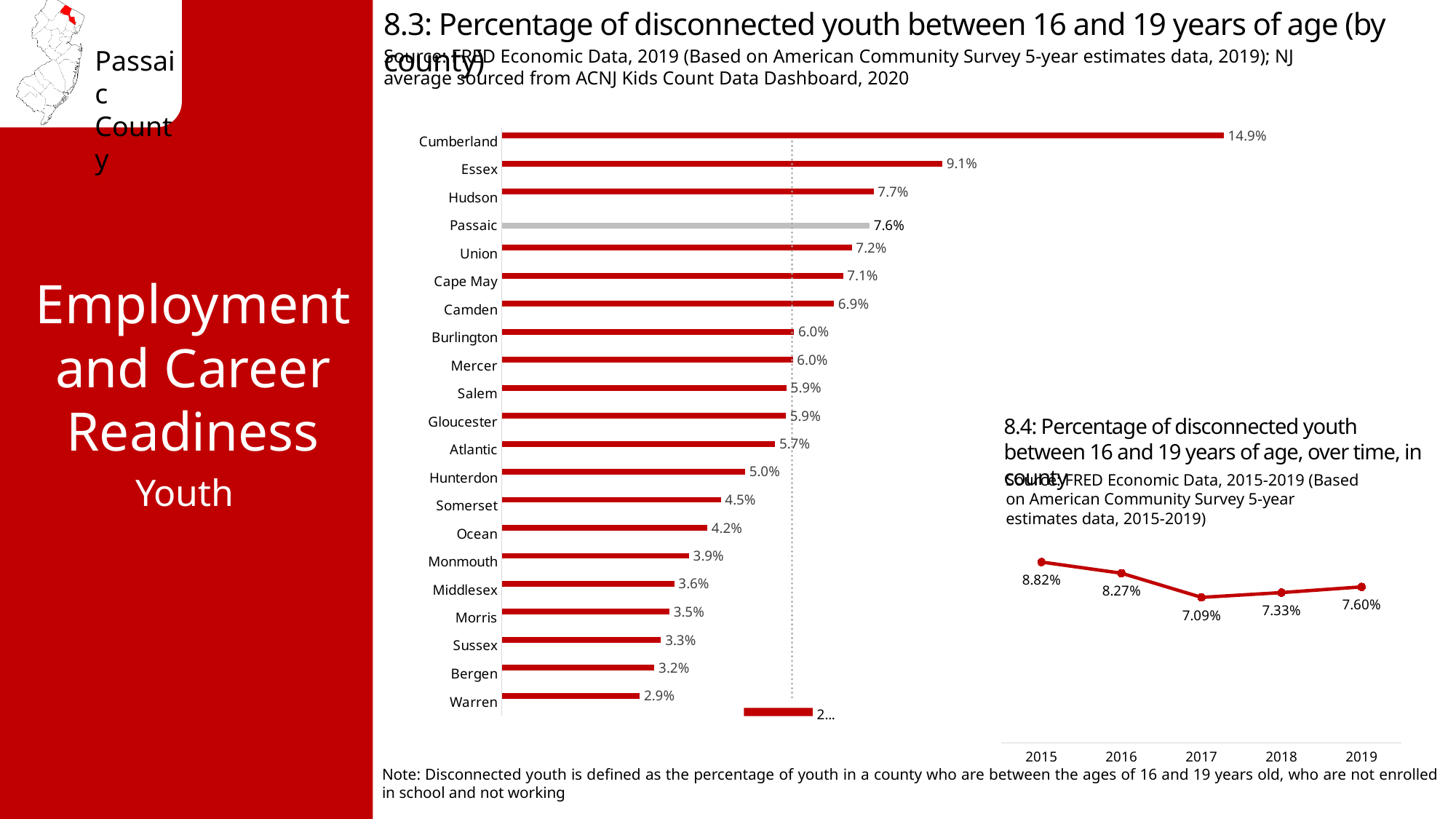
In the chart 8.3 (percentage of disconnected youth by county), what is the value for Passaic? 7.6% In the chart 8.3 (by county), which has a higher value, Hudson or Union? Hudson In the chart 8.4 (disconnected youth over time), what is the value for 2017? 7.09% In the chart 8.3 (by county), what is the value for Bergen? 3.2% In the chart 8.4 (disconnected youth over time), how many years are plotted? 5 What kind of chart is chart 8.3 (percentage of disconnected youth by county)? Bar chart In the chart 8.3 (by county), how many counties are listed on the vertical axis? 21 In the chart 8.3 (by county), which county has the lowest percentage of disconnected youth? Warren In the chart 8.4 (disconnected youth over time), what is the difference between the 2015 and 2019 values? 1.22% In the chart 8.4 (disconnected youth over time), which year has the highest value? 2015 In the chart 8.3 (by county), what is the difference between the values for Cumberland and Essex? 5.8% In the chart 8.3 (by county), which county has the highest percentage of disconnected youth? Cumberland